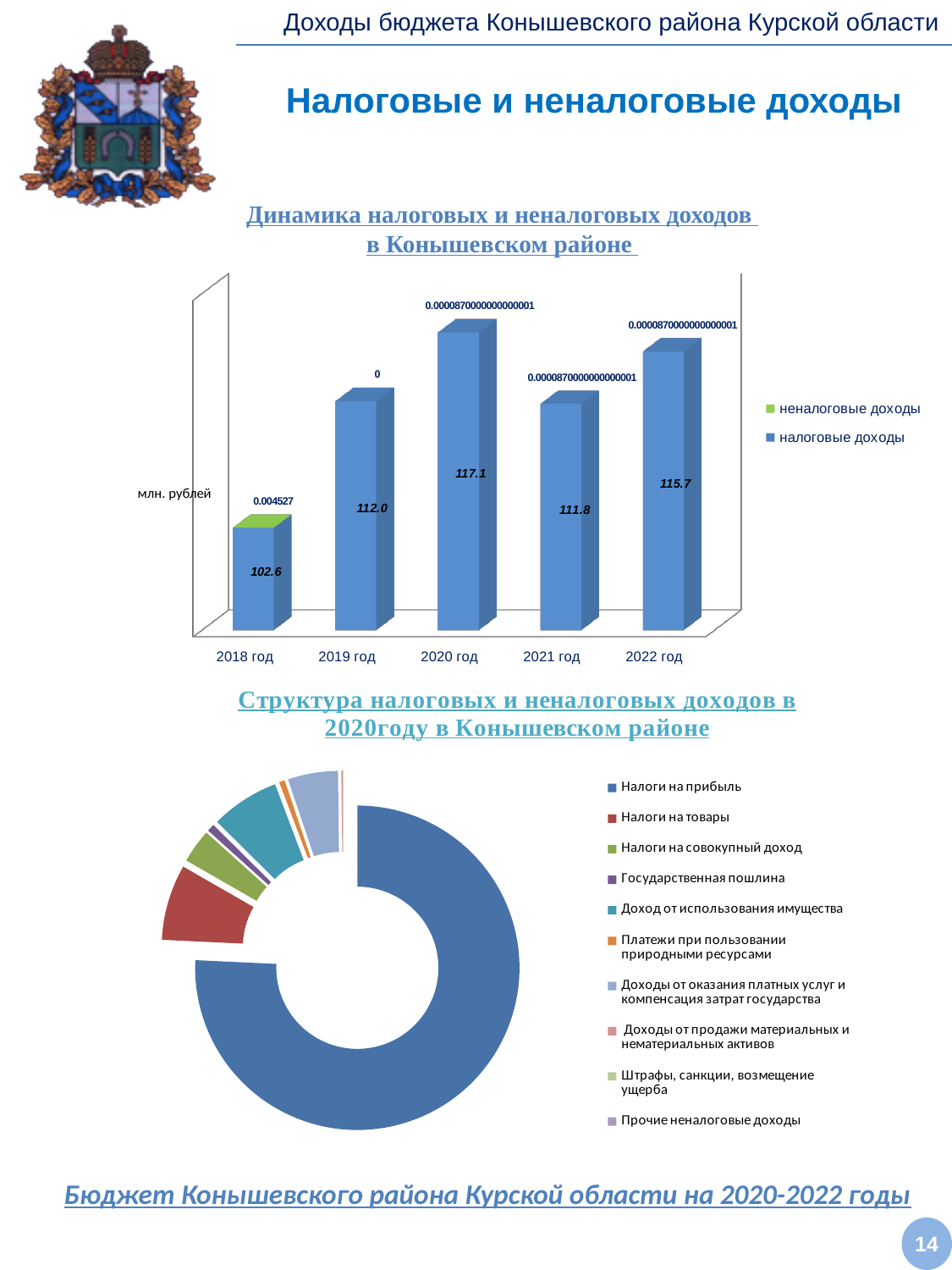
What kind of chart is 'Структура налоговых и неналоговых доходов в 2020году в Конышевском районе'? Doughnut chart In the chart 'Структура налоговых и неналоговых доходов в 2020году в Конышевском районе', which category has the largest slice? Налоги на прибыль In the chart 'Динамика налоговых и неналоговых доходов в Конышевском районе', what is the value of налоговые доходы for 2020 год? 117.1 In the chart 'Динамика налоговых и неналоговых доходов в Конышевском районе', which year has the highest налоговые доходы? 2020 год What kind of chart is 'Динамика налоговых и неналоговых доходов в Конышевском районе'? Bar chart In the chart 'Динамика налоговых и неналоговых доходов в Конышевском районе', what is the value of неналоговые доходы for 2018 год? 0.004527 In the chart 'Динамика налоговых и неналоговых доходов в Конышевском районе', which year has larger налоговые доходы, 2019 год or 2021 год? 2019 год How many years are shown on the x axis of the chart 'Динамика налоговых и неналоговых доходов в Конышевском районе'? 5 In the chart 'Динамика налоговых и неналоговых доходов в Конышевском районе', what is the value of налоговые доходы for 2018 год? 102.6 In the chart 'Динамика налоговых и неналоговых доходов в Конышевском районе', what is the difference in налоговые доходы between 2020 год and 2018 год? 14.5 How many series does the legend of the chart 'Динамика налоговых и неналоговых доходов в Конышевском районе' list? 2 In the chart 'Динамика налоговых и неналоговых доходов в Конышевском районе', which year has the lowest налоговые доходы? 2018 год